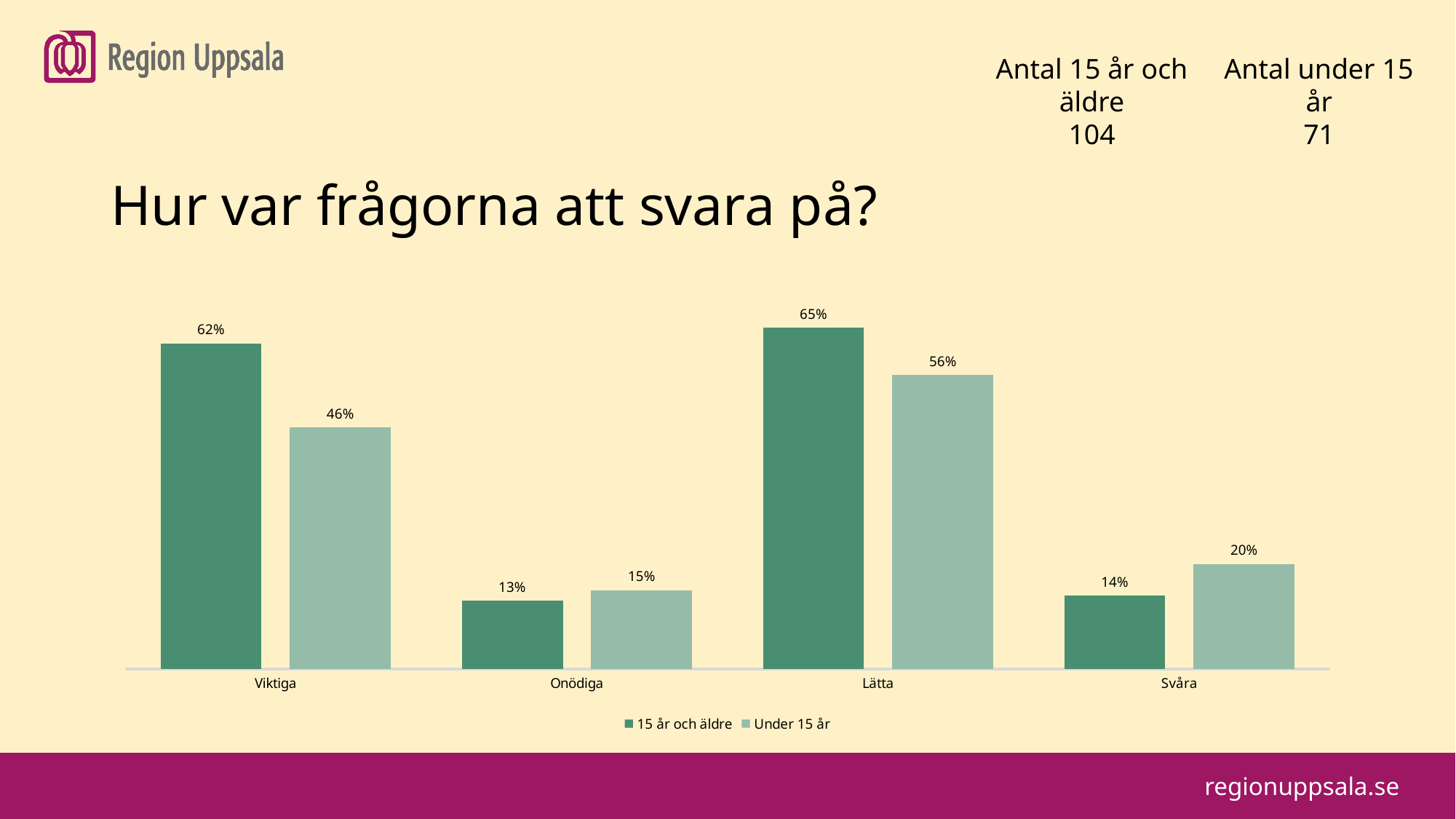
For Svåra, which series has the larger value: '15 år och äldre' or 'Under 15 år'? Under 15 år What is the difference between the '15 år och äldre' and 'Under 15 år' values for Viktiga? 16% What is the value for Lätta in the 'Under 15 år' series? 56% Which category has the lowest value in the '15 år och äldre' series? Onödiga What is the value for Viktiga in the '15 år och äldre' series? 62% What is the value for Svåra in the 'Under 15 år' series? 20% What is the title of the slide above the chart? Hur var frågorna att svara på? What is the difference between the 'Under 15 år' values for Lätta and Onödiga? 41% How many categories are shown on the x axis? 4 What kind of chart is shown on the slide? Bar chart How many series does the legend list? 2 Which category has the highest value in the '15 år och äldre' series? Lätta